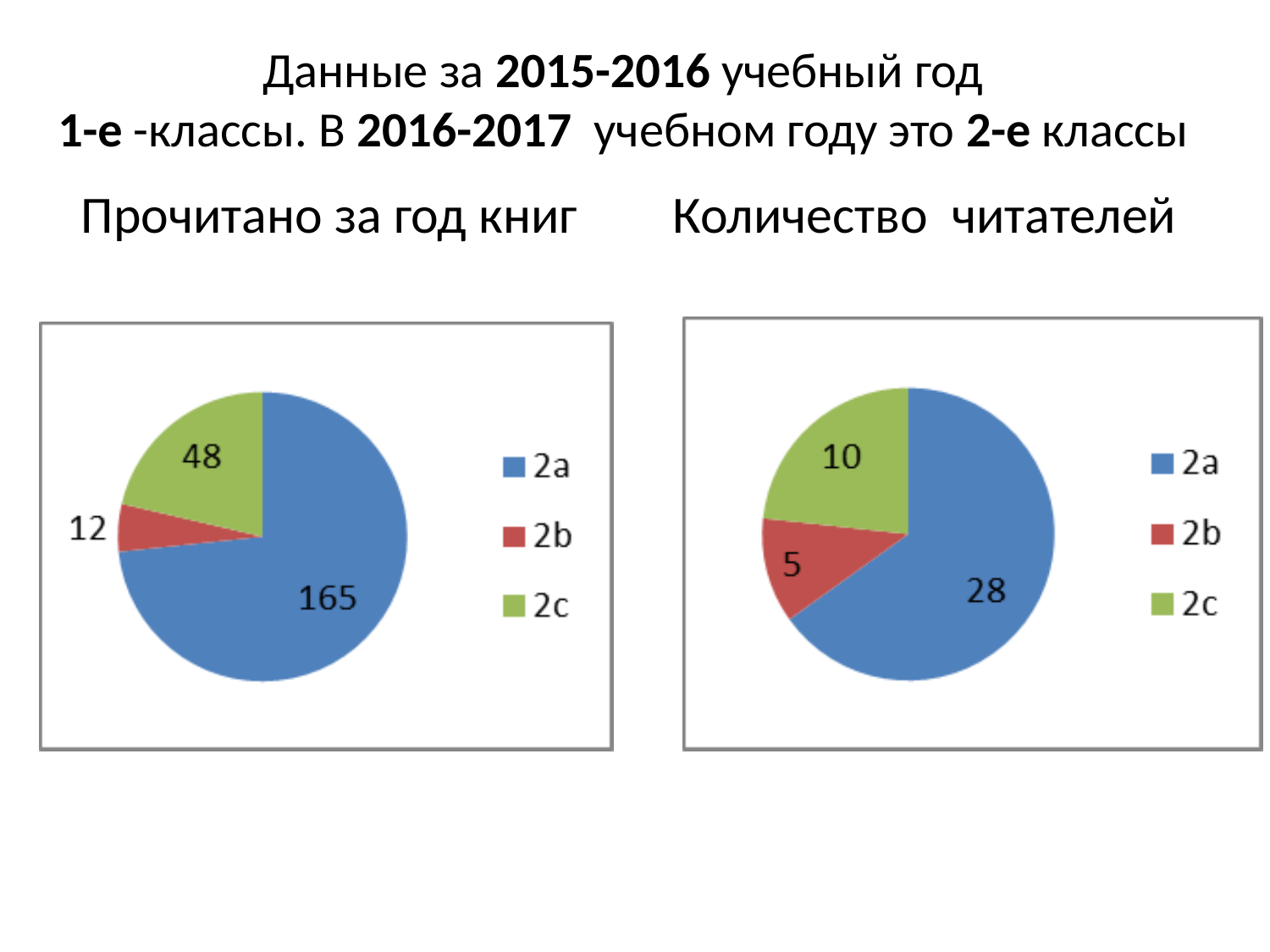
In the chart titled 'Прочитано за год книг', how many books did class 2a read? 165 In the chart titled 'Количество читателей', which colour represents class 2c in the legend? Green In the chart titled 'Прочитано за год книг', what is the difference between the values for 2a and 2c? 117 What type of chart is the chart titled 'Количество читателей'? Pie chart In the chart titled 'Количество читателей', which is larger: the value for 2c or the value for 2b? 2c How many slices does the chart titled 'Прочитано за год книг' have? 3 In the chart titled 'Прочитано за год книг', what is the total of all slices? 225 In the chart titled 'Количество читателей', which class has the largest slice? 2a In the chart titled 'Прочитано за год книг', what is the value for class 2c? 48 In the chart titled 'Количество читателей', what is the value for class 2b? 5 In the chart titled 'Прочитано за год книг', which class has the smallest slice? 2b In the chart titled 'Количество читателей', what is the difference between the values for 2c and 2b? 5